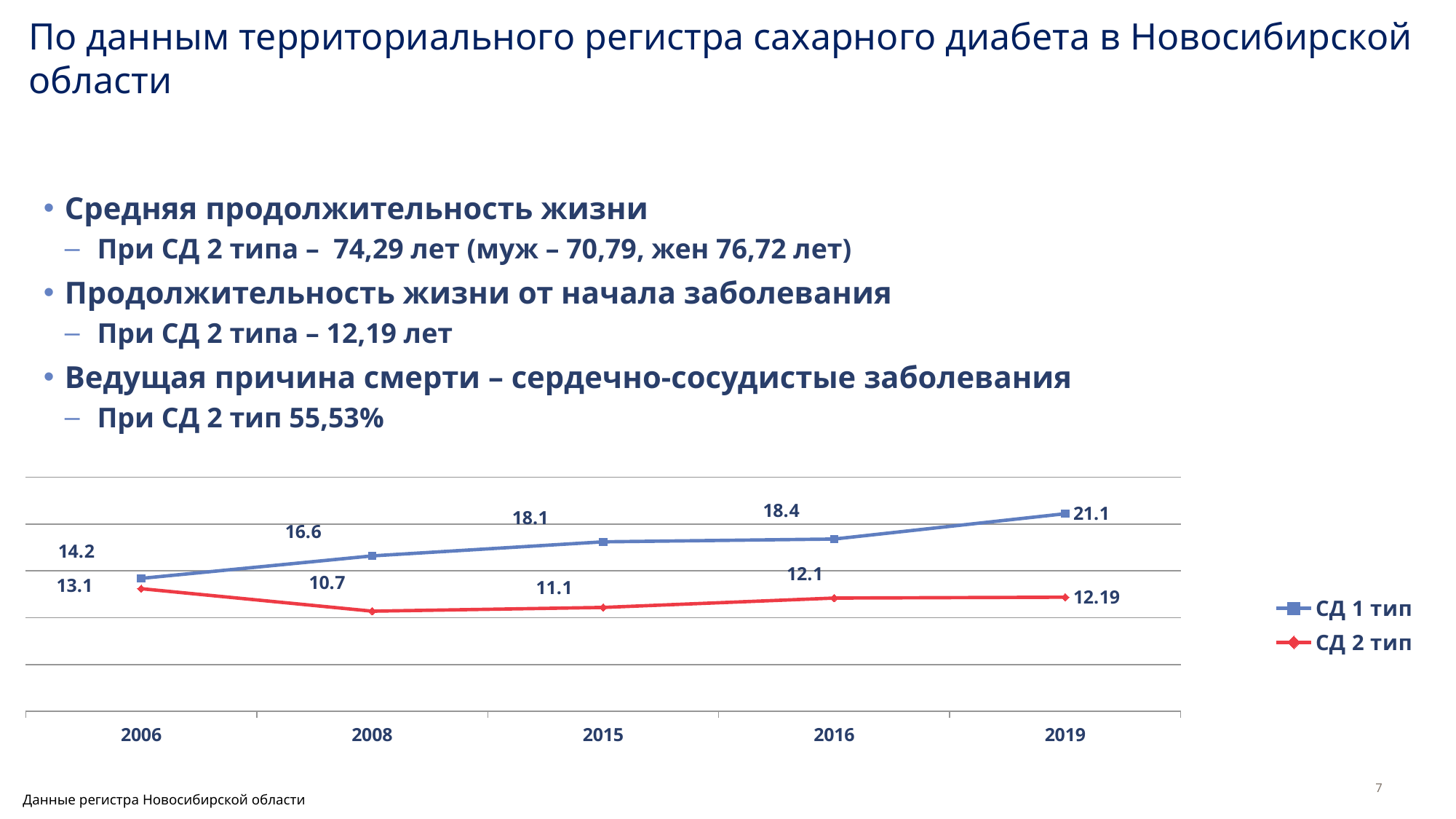
In which year is the value for СД 2 тип lowest? 2008 What is the value for СД 2 тип in 2008? 10.7 What is the value for СД 2 тип in 2019? 12.19 What type of chart is shown on the slide? line chart In which year is the value for СД 1 тип highest? 2019 What is the value for СД 1 тип in 2019? 21.1 How many years are shown on the x axis of the chart? 5 What is the difference between СД 1 тип and СД 2 тип in 2016? 6.3 Which series is drawn in red on the chart? СД 2 тип How many series does the chart legend list? 2 Which series has the larger value in 2006, СД 1 тип or СД 2 тип? СД 1 тип Does the value for СД 1 тип rise or fall from 2006 to 2019? rise